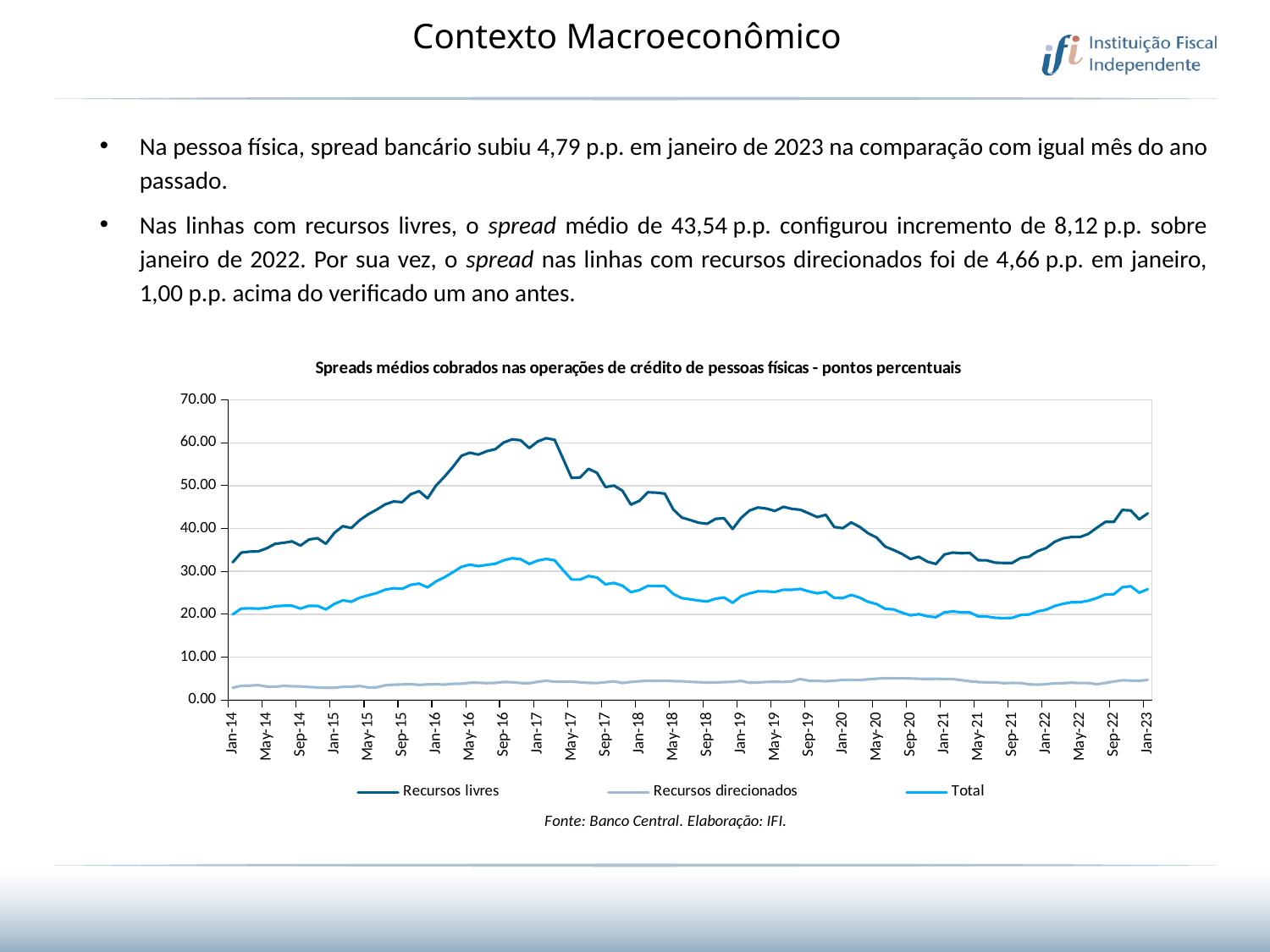
What kind of chart is shown on the slide? Line chart Is the value for Recursos livres at Jan-17 greater or less than 50? greater Which series has the highest values throughout the chart? Recursos livres Is the value for Recursos livres at Sep-21 greater or less than 40? less Which series has the lowest values throughout the chart? Recursos direcionados Is the value for Recursos direcionados at Jan-23 greater or less than 10? less How many series does the chart's legend list? 3 Does the Recursos livres series rise or fall between Jan-17 and Sep-21? fall At Jan-17, which is larger: Recursos livres or Total? Recursos livres Does the Recursos livres series rise or fall between Jan-14 and Jan-17? rise What is the title of the chart? Spreads médios cobrados nas operações de crédito de pessoas físicas - pontos percentuais